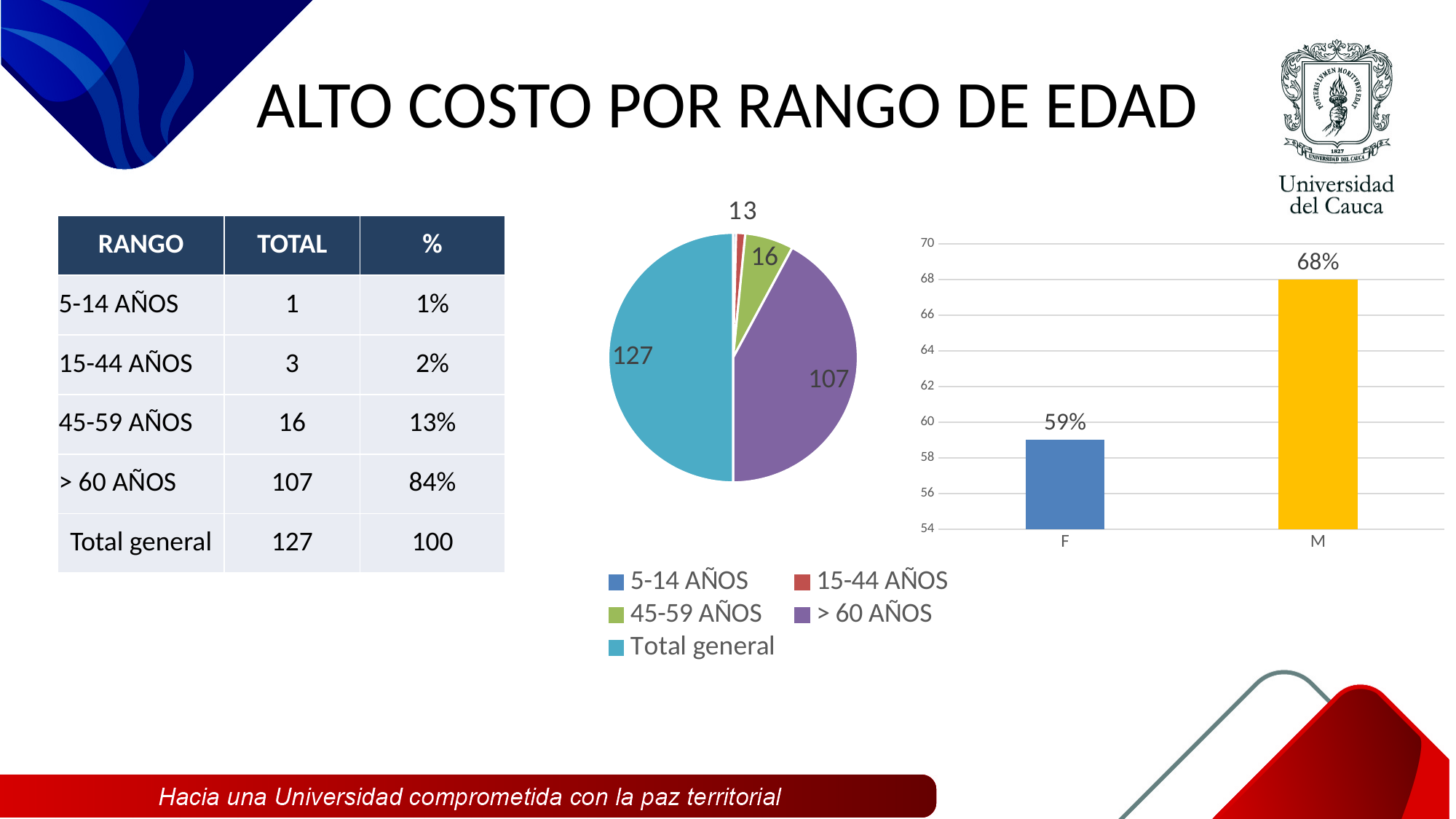
In the pie chart, what value is shown for the Total general slice? 127 In the pie chart, what is the difference between the Total general slice and the > 60 AÑOS slice? 20 What kind of chart is the chart on the right of the slide? Bar chart In the pie chart, what value is shown for the 45-59 AÑOS slice? 16 In the pie chart, how many entries does the legend list? 5 In the bar chart on the right, what is the value for F? 59% In the bar chart on the right, what is the value for M? 68% In the bar chart on the right, which category has the higher value, F or M? M In the bar chart on the right, what is the difference between the values for M and F? 9% In the pie chart, what value is shown for the > 60 AÑOS slice? 107 In the pie chart, what colour is the > 60 AÑOS slice? Purple In the pie chart, which slice is the largest? Total general